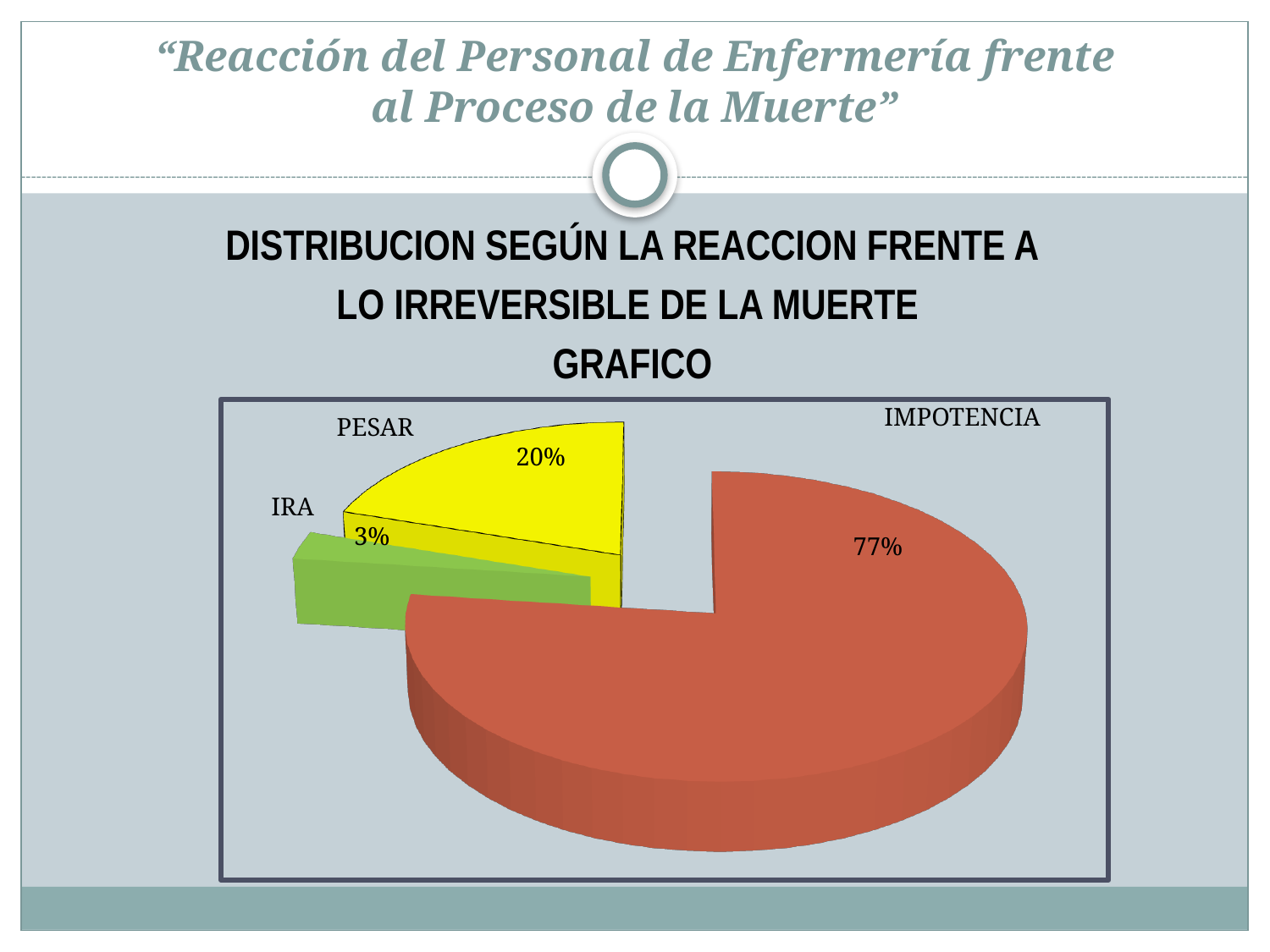
What percentage of the pie is labelled IMPOTENCIA? 77% Which category has the smallest share of the pie? IRA What percentage of the pie is labelled PESAR? 20% What is the difference in percentage points between PESAR and IRA? 17 What kind of chart is shown on the slide? Pie chart What colour is the PESAR slice? Yellow What percentage of the pie is labelled IRA? 3% How many slices does the pie chart have? 3 What is the difference in percentage points between IMPOTENCIA and PESAR? 57 Which is larger, the share for PESAR or the share for IRA? PESAR Which category has the largest share of the pie? IMPOTENCIA What colour is the IMPOTENCIA slice? Red